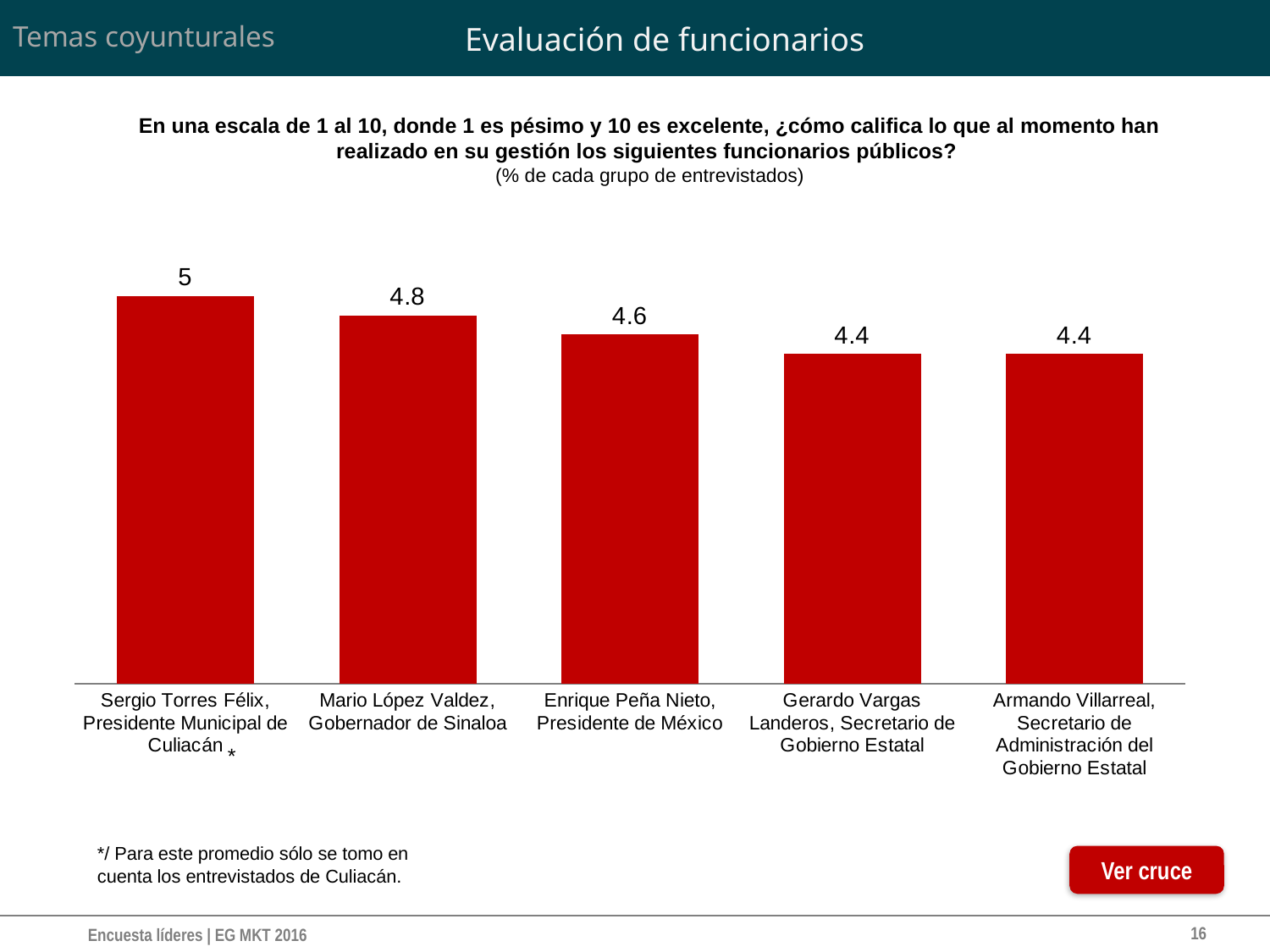
What colour are the bars in the chart? Red What is the value for Sergio Torres Félix, Presidente Municipal de Culiacán? 5 What is the difference between the ratings of Sergio Torres Félix and Enrique Peña Nieto? 0.4 What is the value for Gerardo Vargas Landeros, Secretario de Gobierno Estatal? 4.4 What is the value for Mario López Valdez, Gobernador de Sinaloa? 4.8 Which is larger, the rating for Mario López Valdez or for Enrique Peña Nieto? Mario López Valdez What is the value for Enrique Peña Nieto, Presidente de México? 4.6 What kind of chart is shown on the slide? Bar chart How many officials are shown in the chart? 5 Which official has the highest rating? Sergio Torres Félix, Presidente Municipal de Culiacán What is the difference between the ratings of Mario López Valdez and Gerardo Vargas Landeros? 0.4 Do the values rise or fall from left to right across the chart? Fall